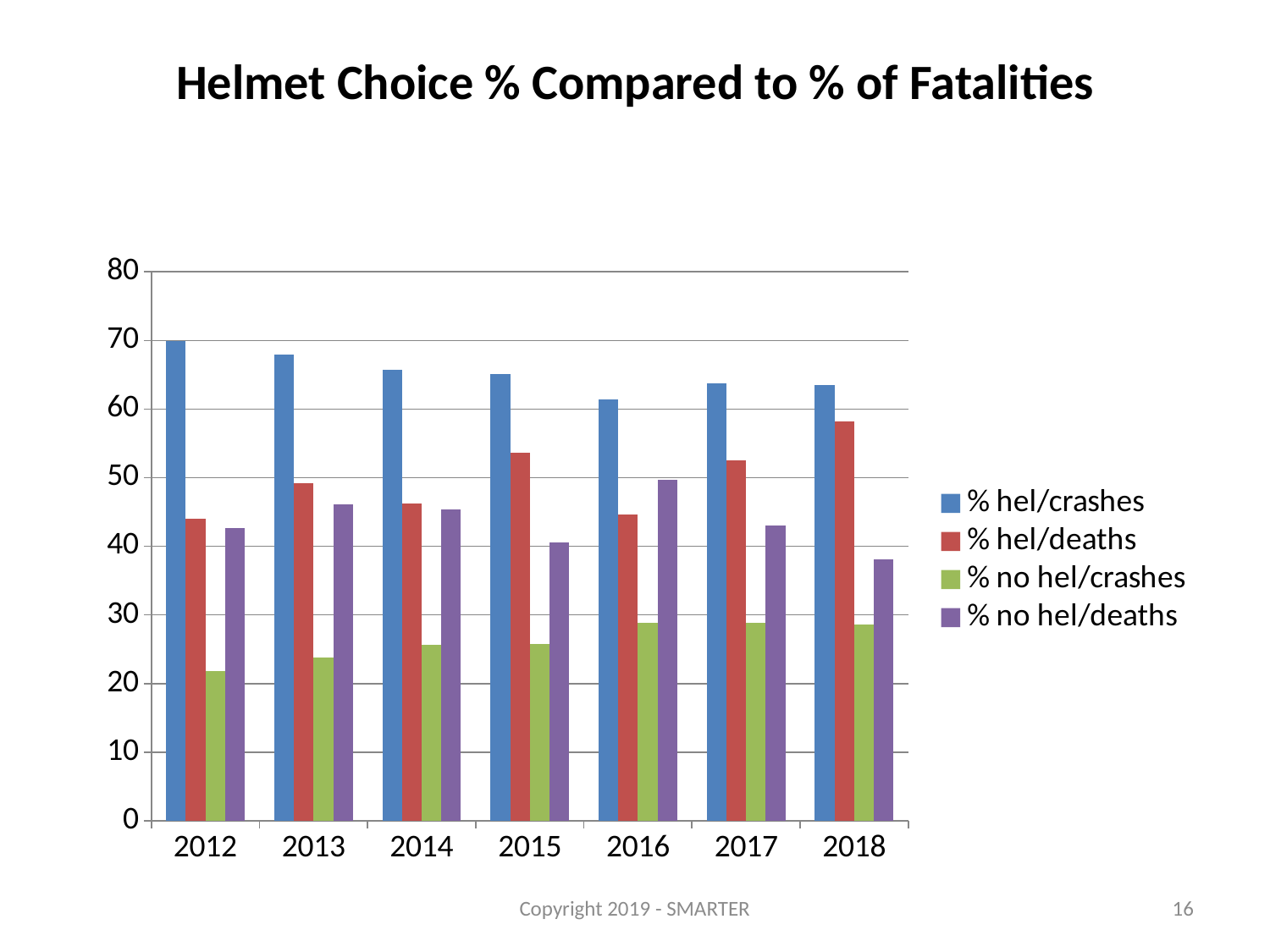
Which year has the highest value for % hel/deaths? 2018 How many series does the legend list? 4 What is the title of the chart? Helmet Choice % Compared to % of Fatalities Does the value for % hel/crashes generally rise or fall from 2012 to 2018? fall What kind of chart is shown on the slide? bar chart How many years are shown on the x axis? 7 Is the value for % no hel/crashes in 2012 greater or less than 30? less Which year has the lowest value for % no hel/crashes? 2012 Which year has the highest value for % hel/crashes? 2012 Which year has the lowest value for % no hel/deaths? 2018 In 2015, which is larger: % hel/deaths or % no hel/deaths? % hel/deaths Is the value for % hel/deaths in 2018 greater or less than 50? greater